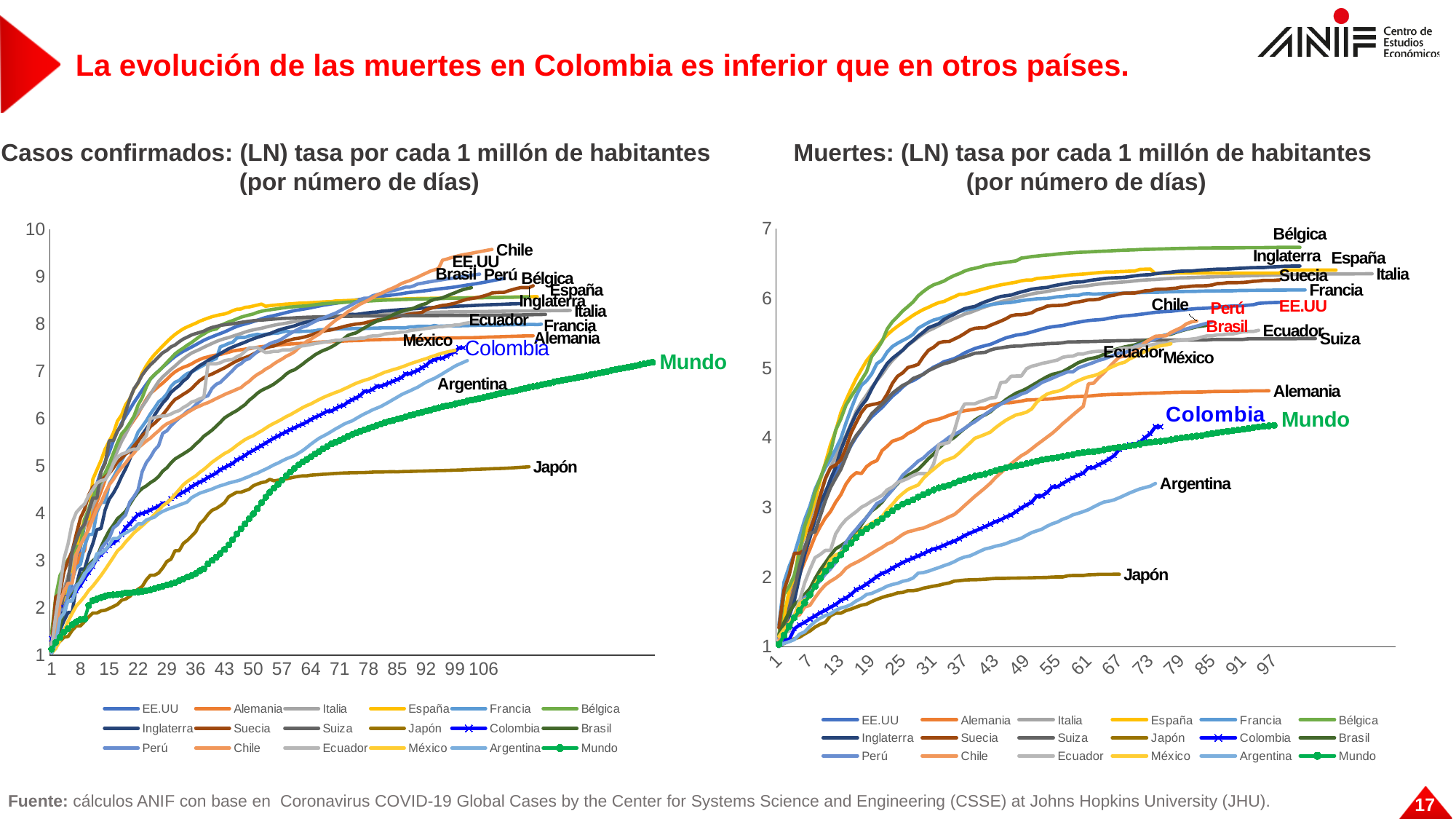
In the left chart (Casos confirmados), which country's line ends highest? Chile In the right chart (Muertes), is the final value for Bélgica greater or less than 6? greater In the left chart (Casos confirmados), is the final value for Japón greater or less than 6? less In the right chart (Muertes), what colour is the Mundo line? Green What kind of chart is the left chart, 'Casos confirmados: (LN) tasa por cada 1 millón de habitantes'? Line chart In the left chart (Casos confirmados), do the values for Mundo rise or fall as the number of days increases? Rise In the left chart (Casos confirmados), which country's line ends lowest? Japón In the right chart (Muertes), which country's line ends lowest? Japón In the right chart (Muertes), which country's line ends highest? Bélgica How many series does the legend of the right chart, 'Muertes: (LN) tasa por cada 1 millón de habitantes', list? 18 In the right chart (Muertes), which line ends higher, Alemania or Colombia? Alemania In the right chart (Muertes), is the final value for Colombia greater or less than 5? less